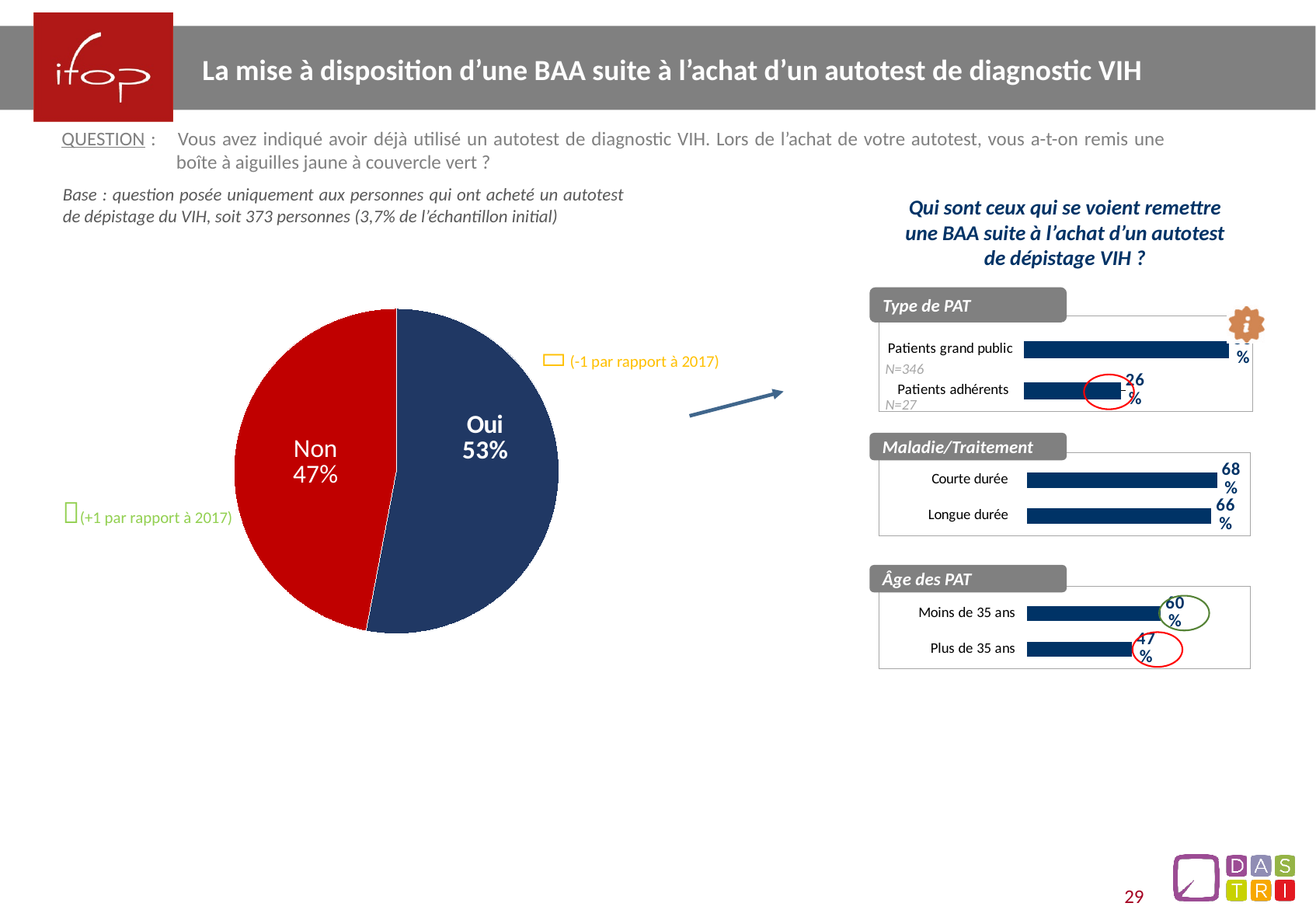
In the pie chart, what share of respondents answered "Non"? 47% In the pie chart, which answer has the larger share, "Oui" or "Non"? Oui How many slices does the pie chart have? 2 In the "Type de PAT" bar chart, which category has the longer bar, "Patients grand public" or "Patients adhérents"? Patients grand public In the "Âge des PAT" bar chart, what is the value for "Plus de 35 ans"? 47% In the "Âge des PAT" bar chart, what is the value for "Moins de 35 ans"? 60% In the pie chart, what is the difference in percentage points between the "Oui" and "Non" shares? 6 points In the "Maladie/Traitement" bar chart, what is the value for "Courte durée"? 68% In the pie chart, what share of respondents answered "Oui"? 53% What type of chart is the large chart on the left of the slide? Pie chart In the "Maladie/Traitement" bar chart, what is the value for "Longue durée"? 66% In the "Âge des PAT" bar chart, what is the difference in percentage points between "Moins de 35 ans" and "Plus de 35 ans"? 13 points